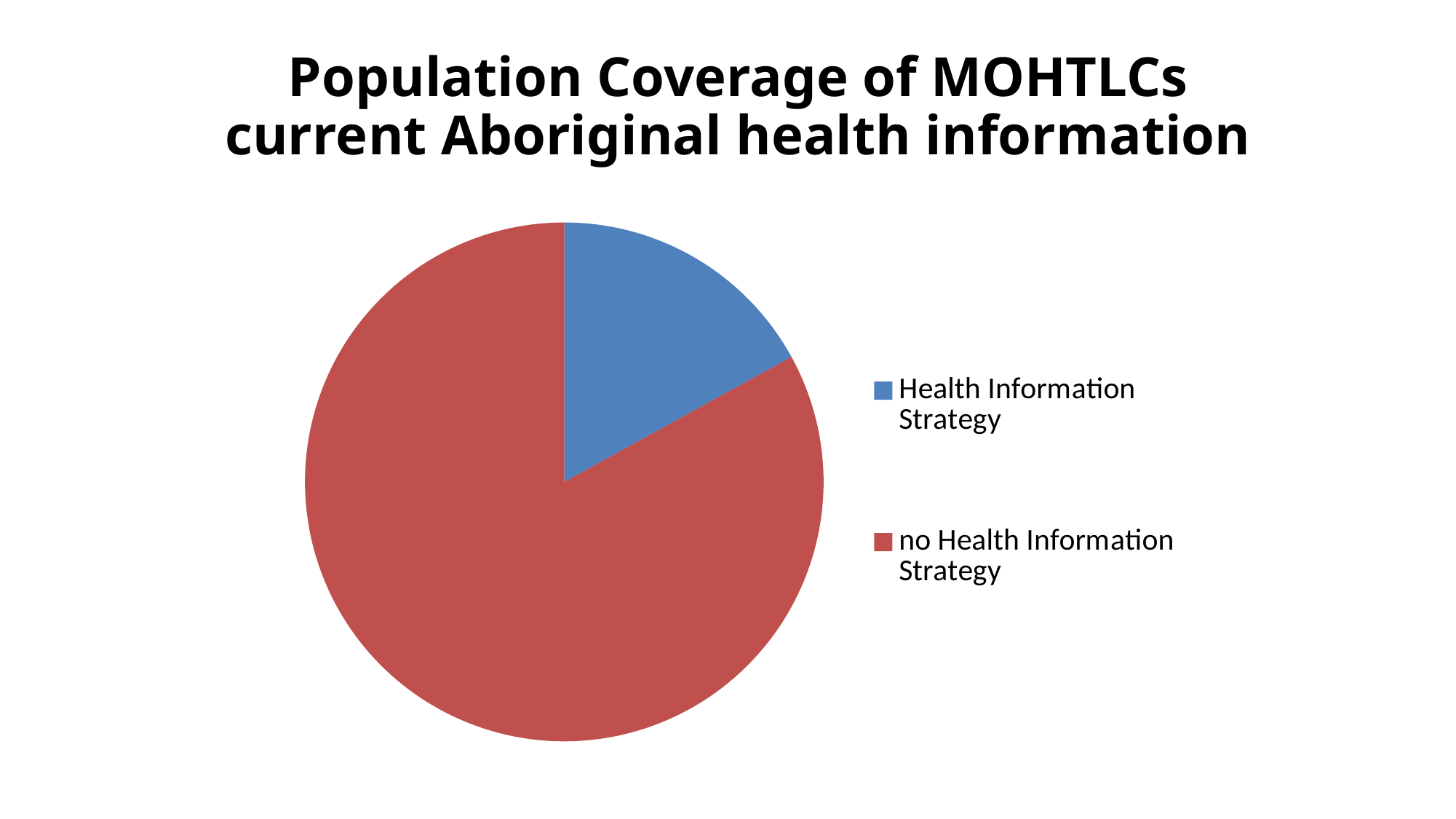
What colour is the slice for no Health Information Strategy? red What is the title of the chart? Population Coverage of MOHTLCs current Aboriginal health information Which slice is the largest in the pie chart? no Health Information Strategy Which slice is the smallest in the pie chart? Health Information Strategy Which is larger: the slice for Health Information Strategy or the slice for no Health Information Strategy? no Health Information Strategy How many slices does the pie chart have? 2 What kind of chart is shown on the slide? pie chart How many entries does the legend list? 2